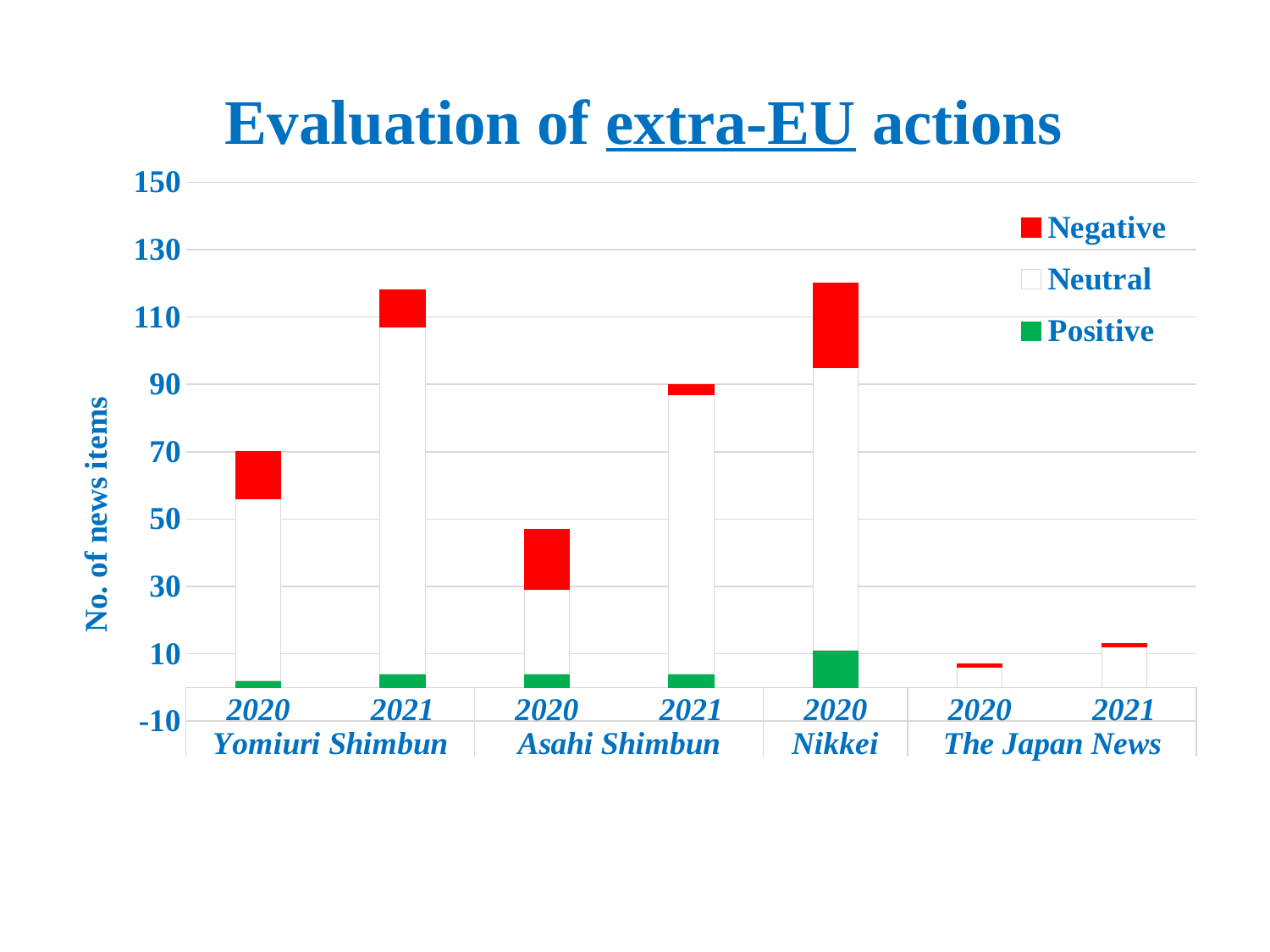
What is the title of the vertical axis? No. of news items What kind of chart is shown on the slide? Stacked bar chart Is the total for The Japan News 2021 greater or less than 10? greater Does the total for Yomiuri Shimbun rise or fall from 2020 to 2021? Rise How many series does the legend list? 3 Which is larger, the total for Yomiuri Shimbun 2020 or Asahi Shimbun 2020? Yomiuri Shimbun 2020 Which bar has the largest Positive segment? Nikkei 2020 Is the total for Yomiuri Shimbun 2021 greater or less than 110? greater Which is larger, the total for Asahi Shimbun 2020 or Asahi Shimbun 2021? Asahi Shimbun 2021 Is the total for Asahi Shimbun 2020 greater or less than 50? less Which bar has the lowest total number of news items? The Japan News 2020 How many bars are plotted in the chart? 7